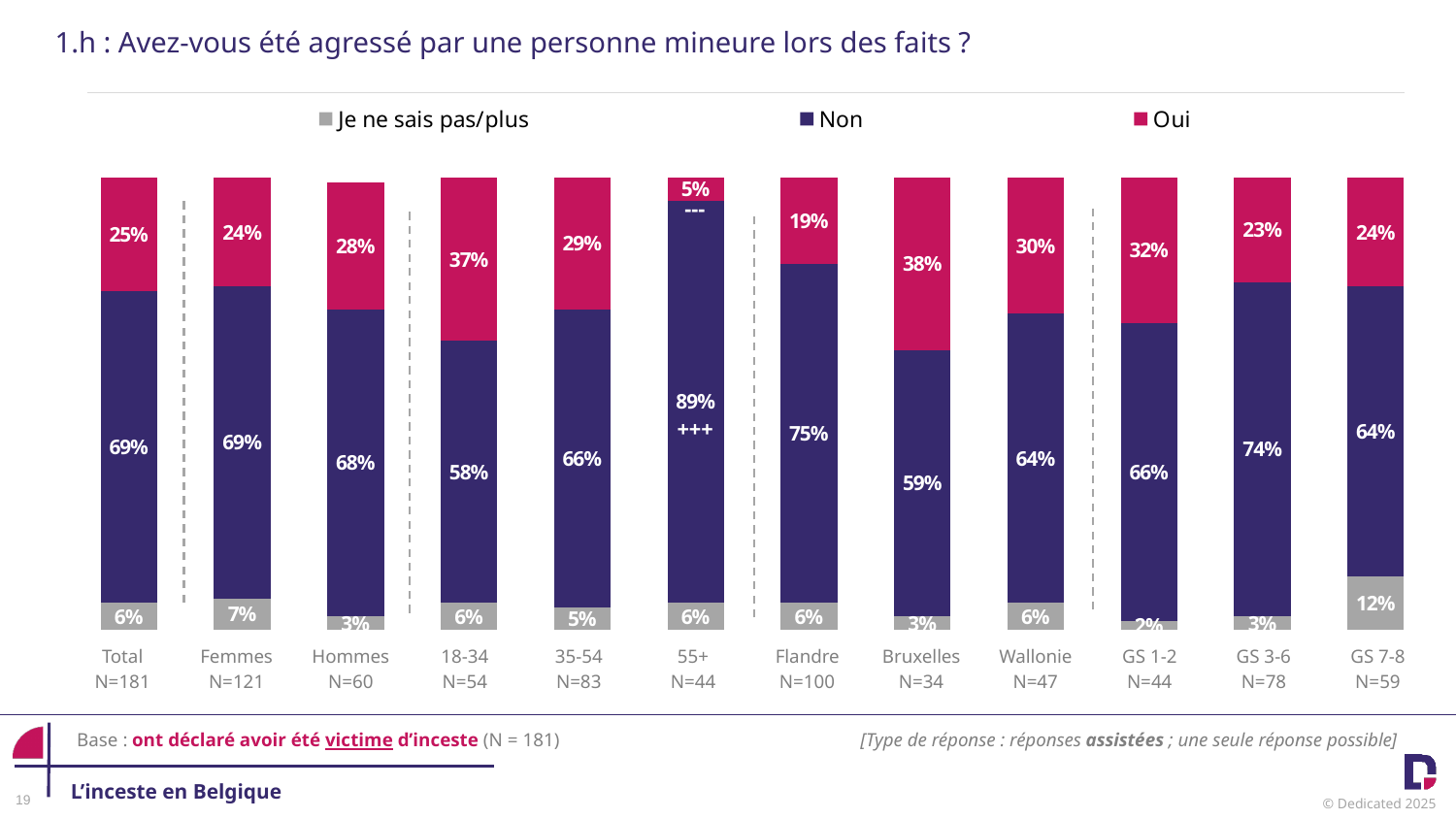
Which has a larger 'Non' value, Flandre or Bruxelles? Flandre How many series does the legend list? 3 Which category has the highest 'Non' value? 55+ What is the 'Oui' value for the Total bar? 25% What type of chart is shown on the slide? Stacked bar chart How many categories (bars) are shown on the chart? 12 What is the sample size (N) shown for the Femmes category? N=121 What is the difference between the 'Non' and 'Oui' values for the Total bar? 44 percentage points What is the 'Je ne sais pas/plus' value for GS 7-8? 12% What is the 'Non' value for the 55+ group? 89% Which category has the lowest 'Oui' value? 55+ Which category has the lowest 'Non' value? 18-34